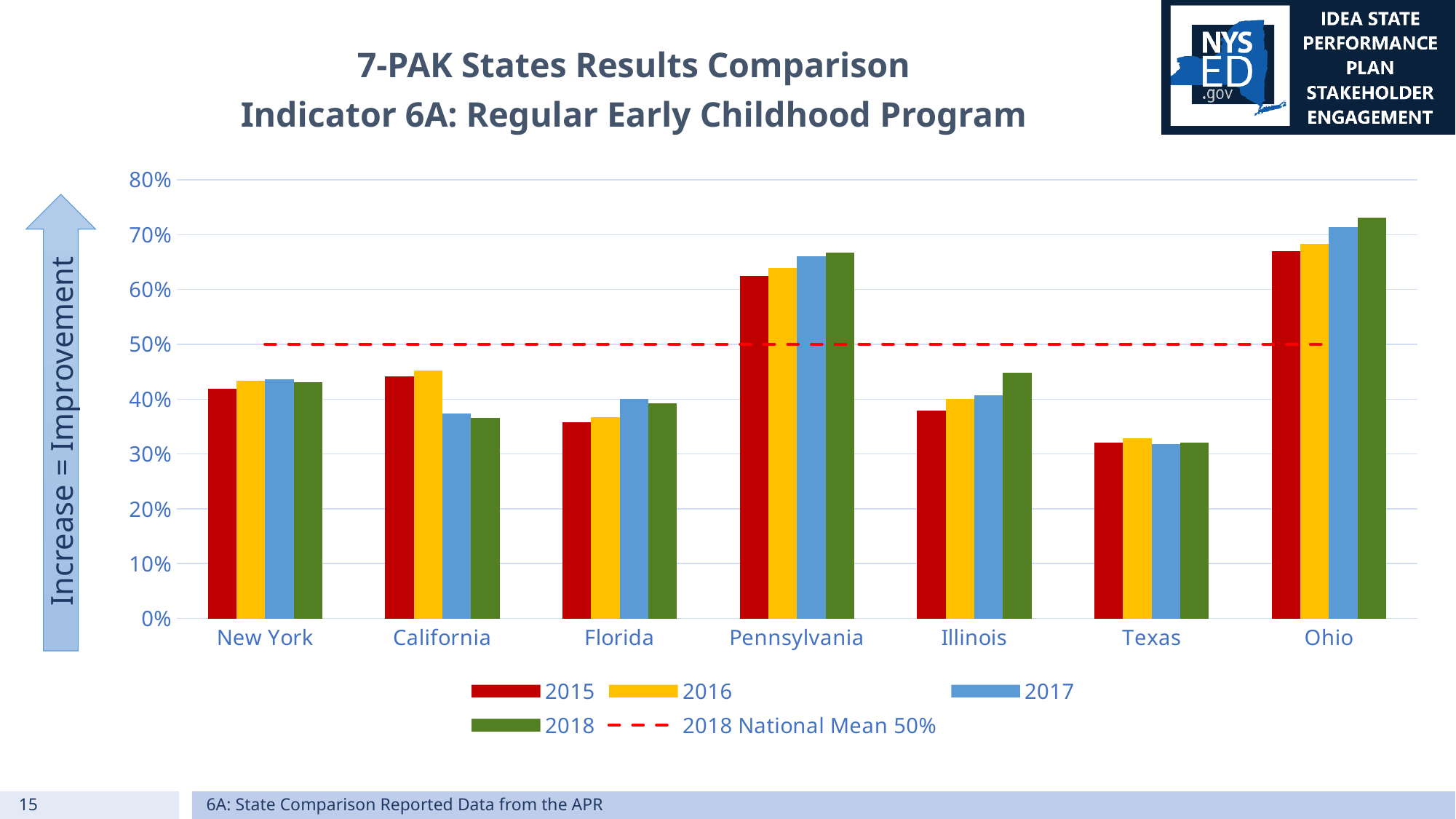
How many states are shown on the x axis of the chart? 7 Which state has the highest 2018 value? Ohio Is the 2018 value for Pennsylvania greater or less than 60%? greater Which state has the lowest 2018 value? Texas Do Ohio's values rise or fall from 2015 to 2018? rise Is the 2018 value for Illinois greater or less than 40%? greater Which is larger for California, the 2016 value or the 2018 value? 2016 Which is larger, the 2018 value for Ohio or the 2018 value for Pennsylvania? Ohio Is the 2015 value for Texas greater or less than 40%? less How many entries does the chart's legend list? 5 What kind of chart is shown on the slide? Bar chart What value does the dashed red line in the chart represent? 2018 National Mean 50%